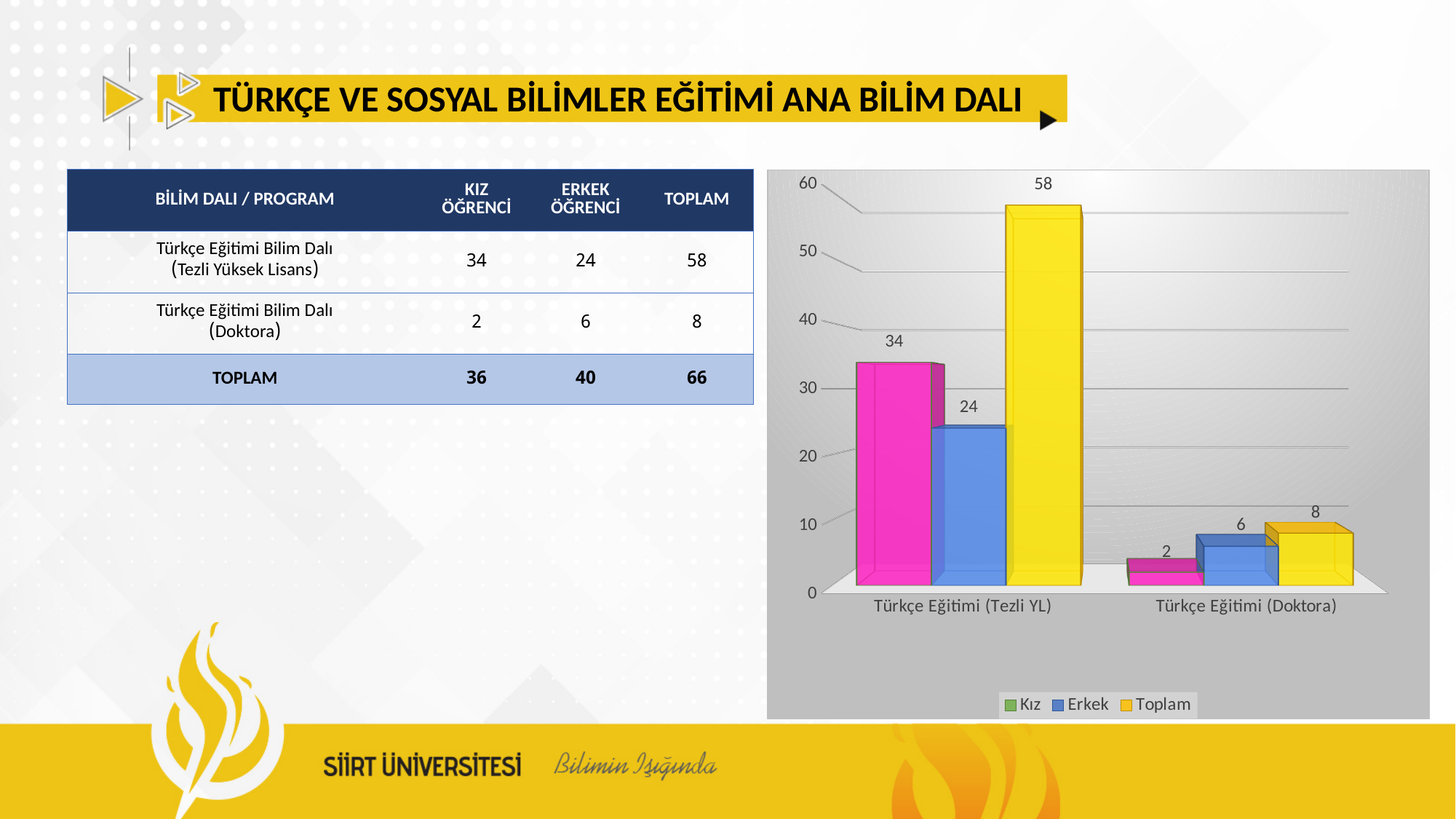
How many series does the legend list? 3 What is the value of Erkek for Türkçe Eğitimi (Tezli YL)? 24 What is the value of Kız for Türkçe Eğitimi (Tezli YL)? 34 What is the value of Kız for Türkçe Eğitimi (Doktora)? 2 What is the difference between the Kız and Erkek values for Türkçe Eğitimi (Tezli YL)? 10 What kind of chart is shown on the slide? bar chart What is the value of Toplam for Türkçe Eğitimi (Doktora)? 8 How many categories are shown on the x axis? 2 Is the Toplam value for Türkçe Eğitimi (Tezli YL) greater or less than 50? greater Which category has the highest Toplam value? Türkçe Eğitimi (Tezli YL) Which is larger for Türkçe Eğitimi (Doktora): Kız or Erkek? Erkek Which series has the lowest value for Türkçe Eğitimi (Doktora)? Kız